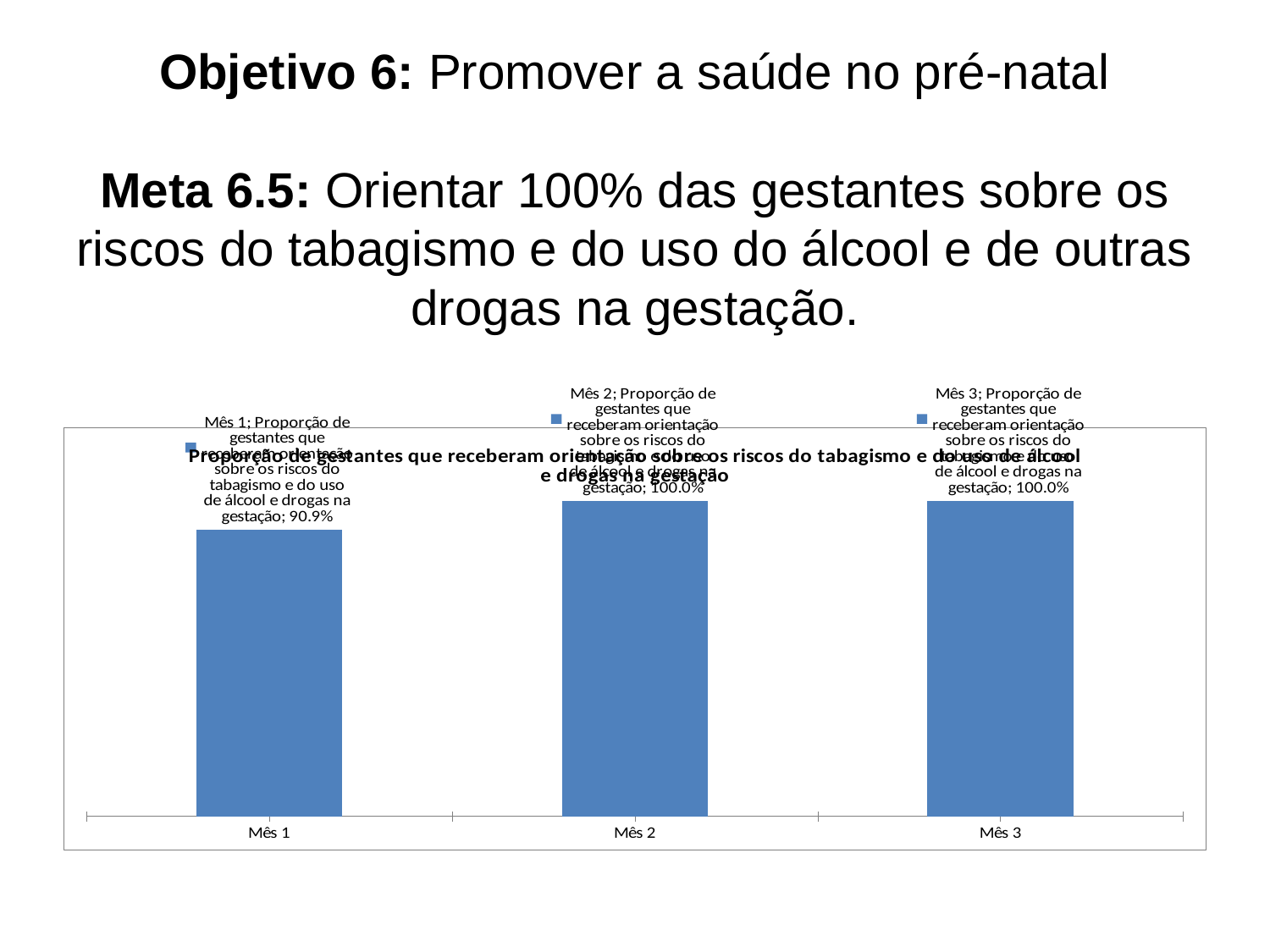
What colour are the bars in the chart? Blue Which is larger, the value for Mês 1 or the value for Mês 3? Mês 3 What kind of chart is shown on the slide? Bar chart Do the values for Mês 2 and Mês 3 differ? No, both are 100.0% What is the title of the chart? Proporção de gestantes que receberam orientação sobre os riscos do tabagismo e do uso de álcool e drogas na gestação What is the value for Mês 3? 100.0% Which month has the lowest value? Mês 1 How many months are shown on the x axis? 3 What is the difference between the values for Mês 2 and Mês 1? 9.1% What is the value for Mês 2? 100.0% Do the values rise or fall from Mês 1 to Mês 2? Rise What is the value for Mês 1? 90.9%